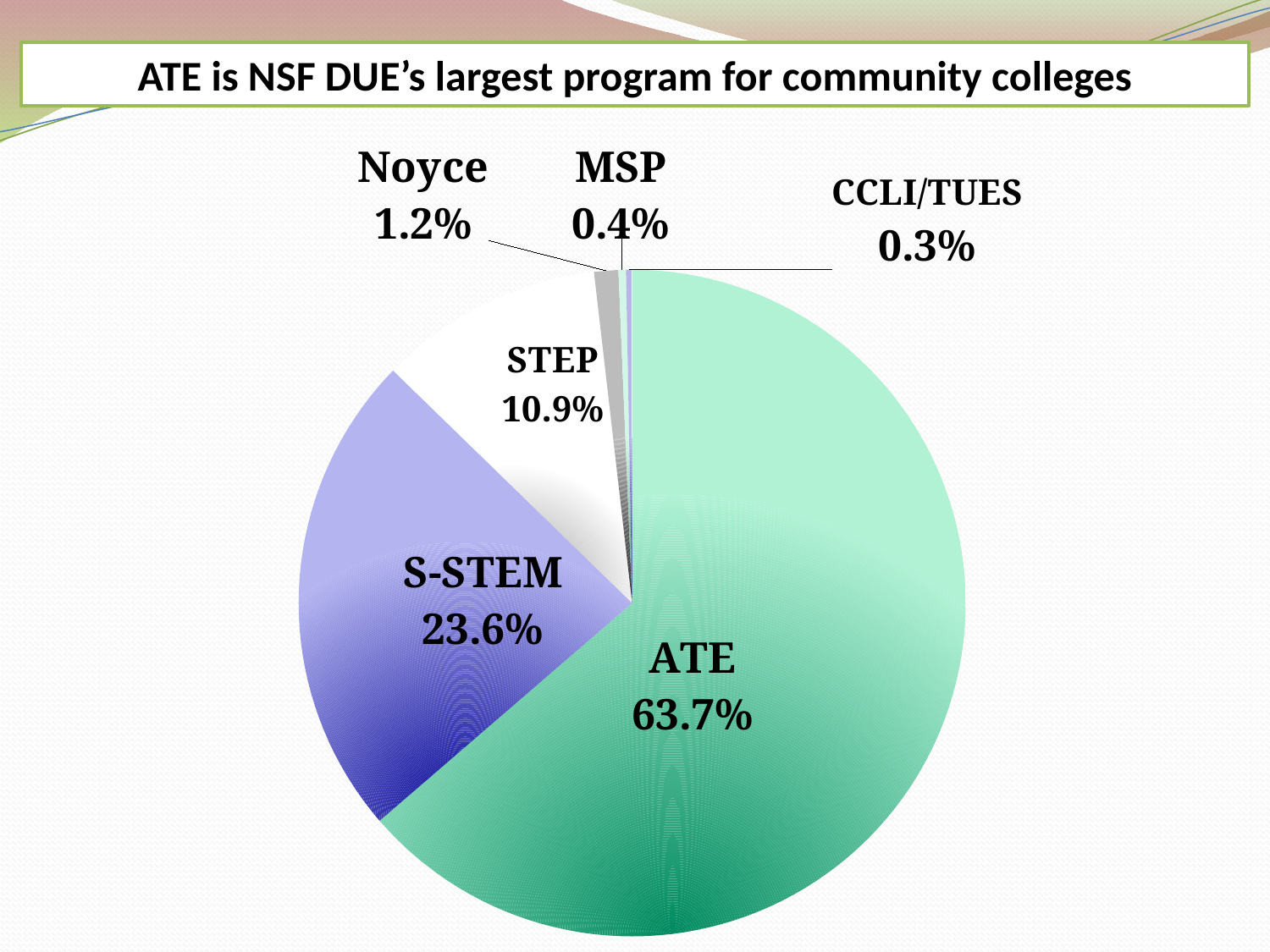
What share of the pie does S-STEM have? 23.6% What share of the pie does CCLI/TUES have? 0.3% Which program has the largest slice of the pie? ATE Which is larger, the share for STEP or the share for Noyce? STEP What share of the pie does Noyce have? 1.2% What share of the pie does STEP have? 10.9% What share of the pie does MSP have? 0.4% What share of the pie does ATE have? 63.7% What kind of chart is shown on the slide? pie chart What is the difference in percentage points between ATE and S-STEM? 40.1 Which program has the smallest slice of the pie? CCLI/TUES How many slices does the pie chart have? 6